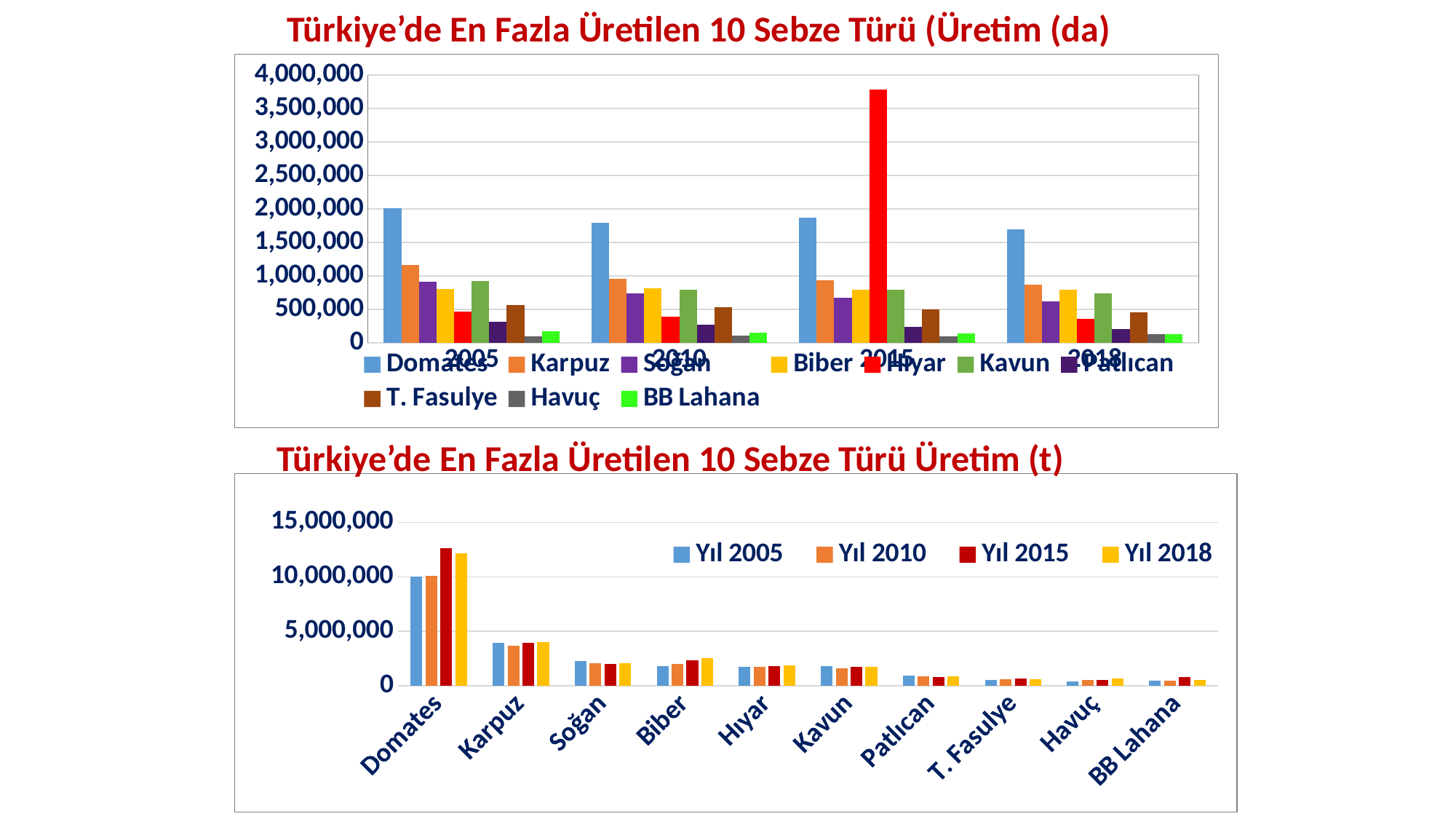
In the top chart (Üretim (da)), which series has the tallest bar in 2015? Hıyar In the top chart (Üretim (da)), is the value for Karpuz in 2005 greater or less than 1,000,000? greater How many series does the legend of the top chart (Üretim (da)) list? 10 In the bottom chart (Üretim (t)), is the value for Domates in Yıl 2015 greater or less than 10,000,000? greater In the top chart (Üretim (da)), is the value for Domates in 2010 greater or less than 2,000,000? less What kind of chart is the bottom chart (Üretim (t))? Bar chart How many year categories are shown on the x axis of the top chart (Üretim (da))? 4 In the top chart (Üretim (da)), which series has the shortest bar in 2005? Havuç In the top chart (Üretim (da)), which is larger in 2018: Domates or Karpuz? Domates In the bottom chart (Üretim (t)), which vegetable has the highest bars? Domates